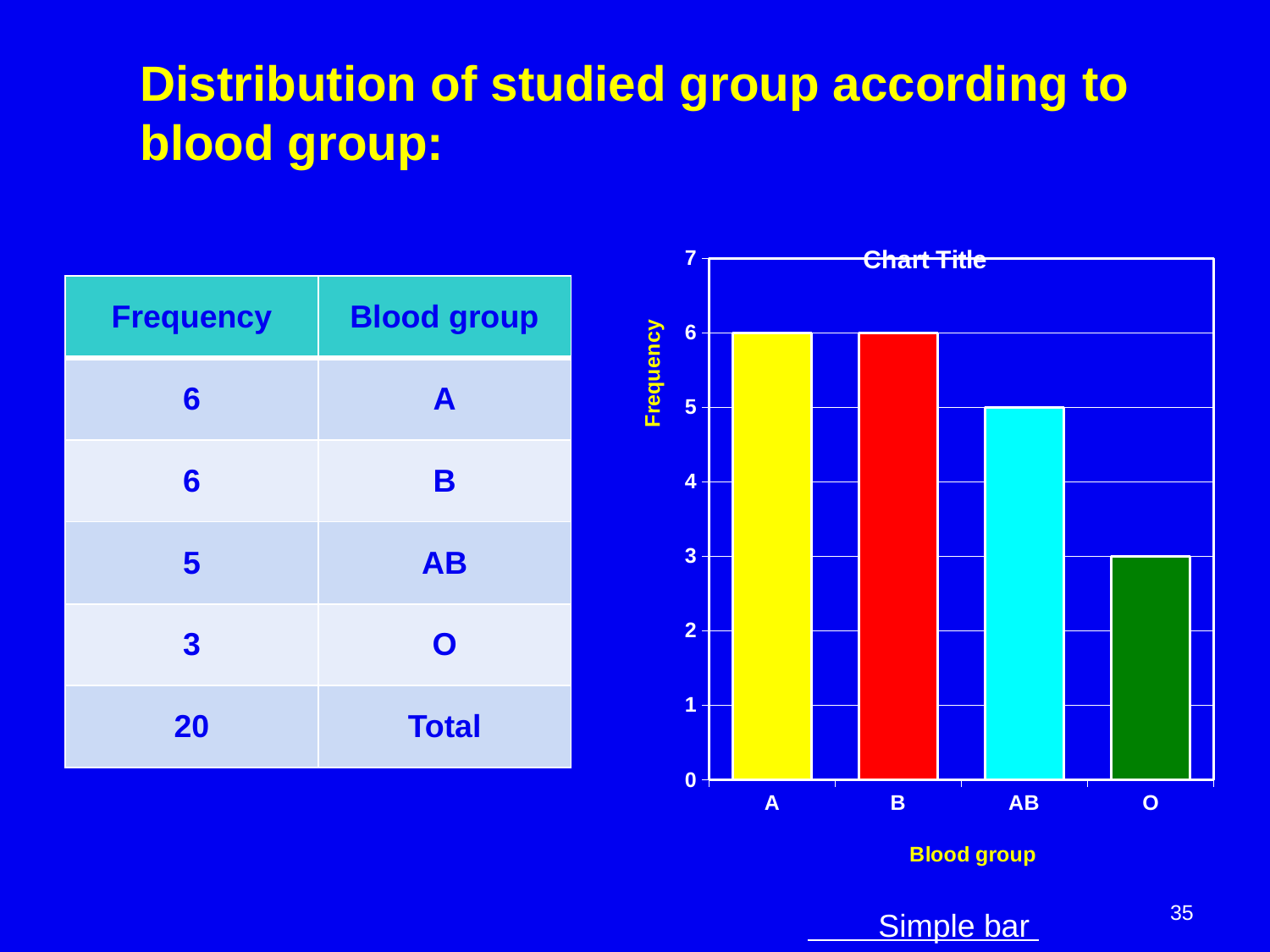
What colour is the bar for blood group B? red How many blood group categories are shown on the x axis of the chart? 4 Which has a higher frequency, blood group AB or blood group O? AB What is the frequency for blood group O in the bar chart? 3 Which blood group has the lowest frequency in the bar chart? O What is the label of the vertical axis of the chart? Frequency What is the frequency for blood group A in the bar chart? 6 What is the difference in frequency between blood group AB and blood group O? 2 What kind of chart is shown on the slide? bar chart Is the frequency for blood group O greater or less than 4? less What is the difference in frequency between blood group B and blood group AB? 1 What is the frequency for blood group AB in the bar chart? 5